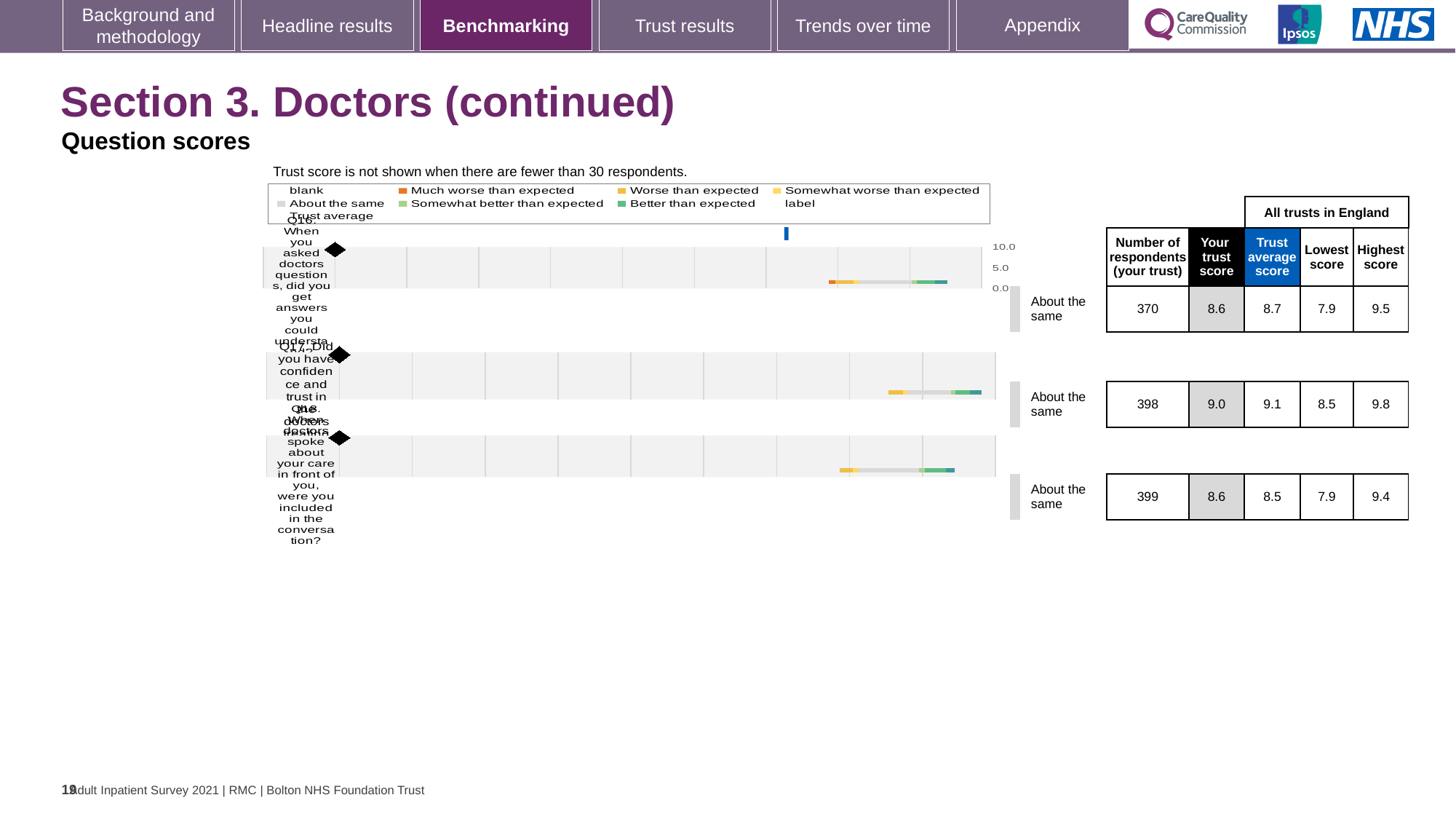
What is the trust average score for Q18 (When doctors spoke about your care in front of you, were you included in the conversation)? 8.5 What is the trust's score for Q16 (When you asked doctors questions, did you get answers you could understand)? 8.6 What benchmark category is shown for all three questions? About the same What is the difference between the highest score and the lowest score for Q17? 1.3 What kind of chart is used to show the question scores on this slide? bar chart Is the trust score marker for Q17 greater or less than 5.0 on the axis? greater For Q16, which is larger: the trust's own score or the trust average score? Trust average score (8.7) According to the note above the chart, when is the trust score not shown? When there are fewer than 30 respondents How many questions are plotted in the chart? 3 What is the lowest score across all trusts in England for Q18? 7.9 Which question has the highest 'Your trust score'? Q17 How many respondents from the trust answered Q17 (Did you have confidence and trust in the doctors treating you)? 398